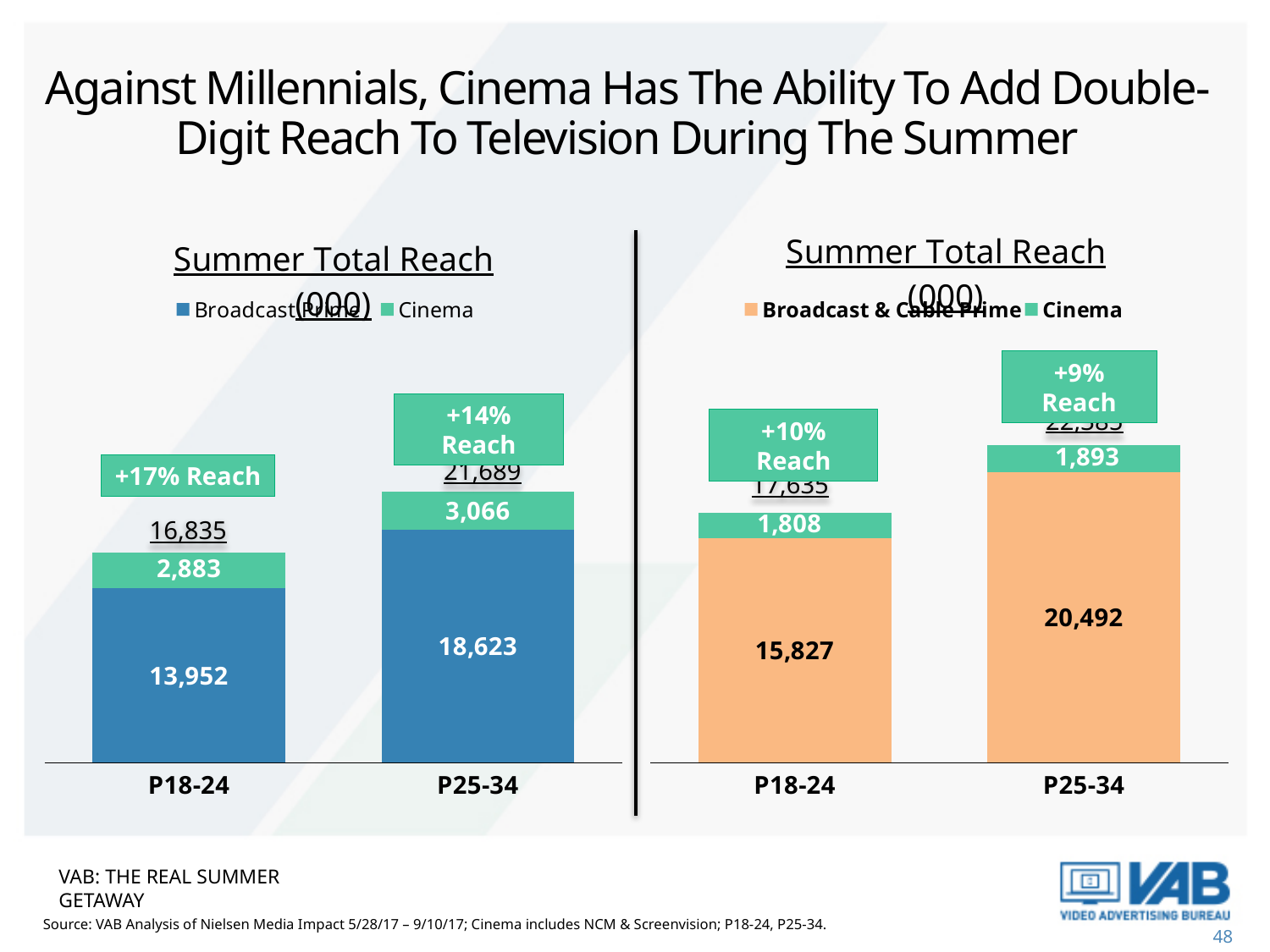
In the right chart, what is the total reach shown above the P18-24 bar? 17,635 In the right chart, which age group has the larger Cinema value, P18-24 or P25-34? P25-34 In the left chart, what is the Broadcast Prime value for P18-24? 13,952 In the left chart, what is the total reach shown above the P25-34 bar? 21,689 In the left chart, what is the total reach shown above the P18-24 bar? 16,835 In the left chart, what percentage reach does Cinema add for P18-24? +17% Reach In the right chart, what is the Cinema value for P18-24? 1,808 In the left chart, what is the difference between the Broadcast Prime values for P25-34 and P18-24? 4,671 What type of chart is shown on the left side of the slide? Stacked bar chart In the right chart, what is the Broadcast & Cable Prime value for P25-34? 20,492 In the left chart, what is the Cinema value for P25-34? 3,066 In the right chart, what percentage reach does Cinema add for P25-34? +9% Reach